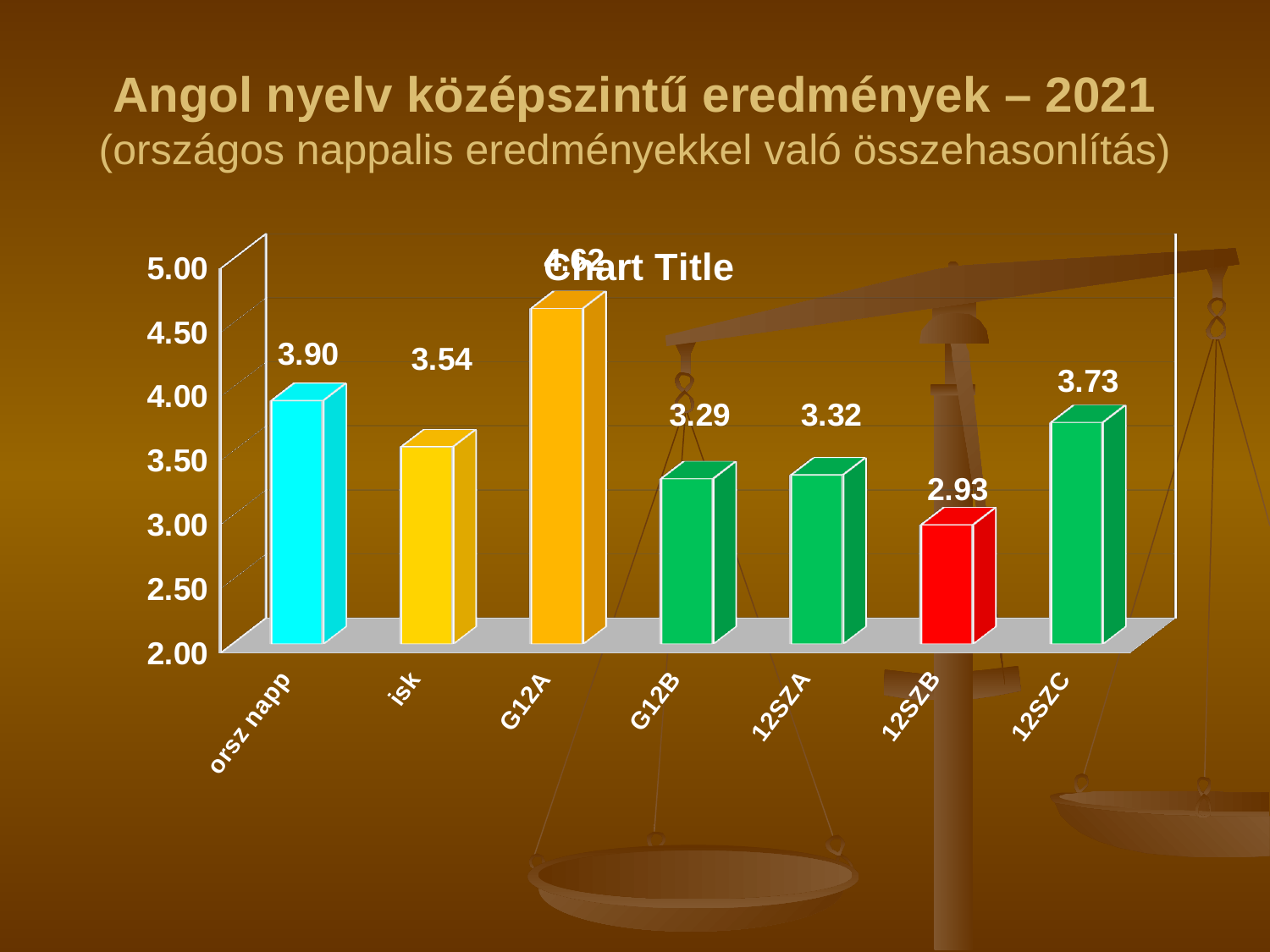
Which category has the lowest value? 12SZB What is the value for isk? 3.54 What is the value for 12SZB? 2.93 What is the value for 12SZC? 3.73 Which category has the highest value? G12A What is the value for orsz napp? 3.90 What is the difference between the values for orsz napp and isk? 0.36 What is the difference between the values for 12SZC and 12SZB? 0.80 Is the value for G12A greater or less than 4.50? greater Which is larger, the value for G12B or the value for 12SZC? 12SZC How many categories are shown on the x axis? 7 What kind of chart is shown on the slide? bar chart